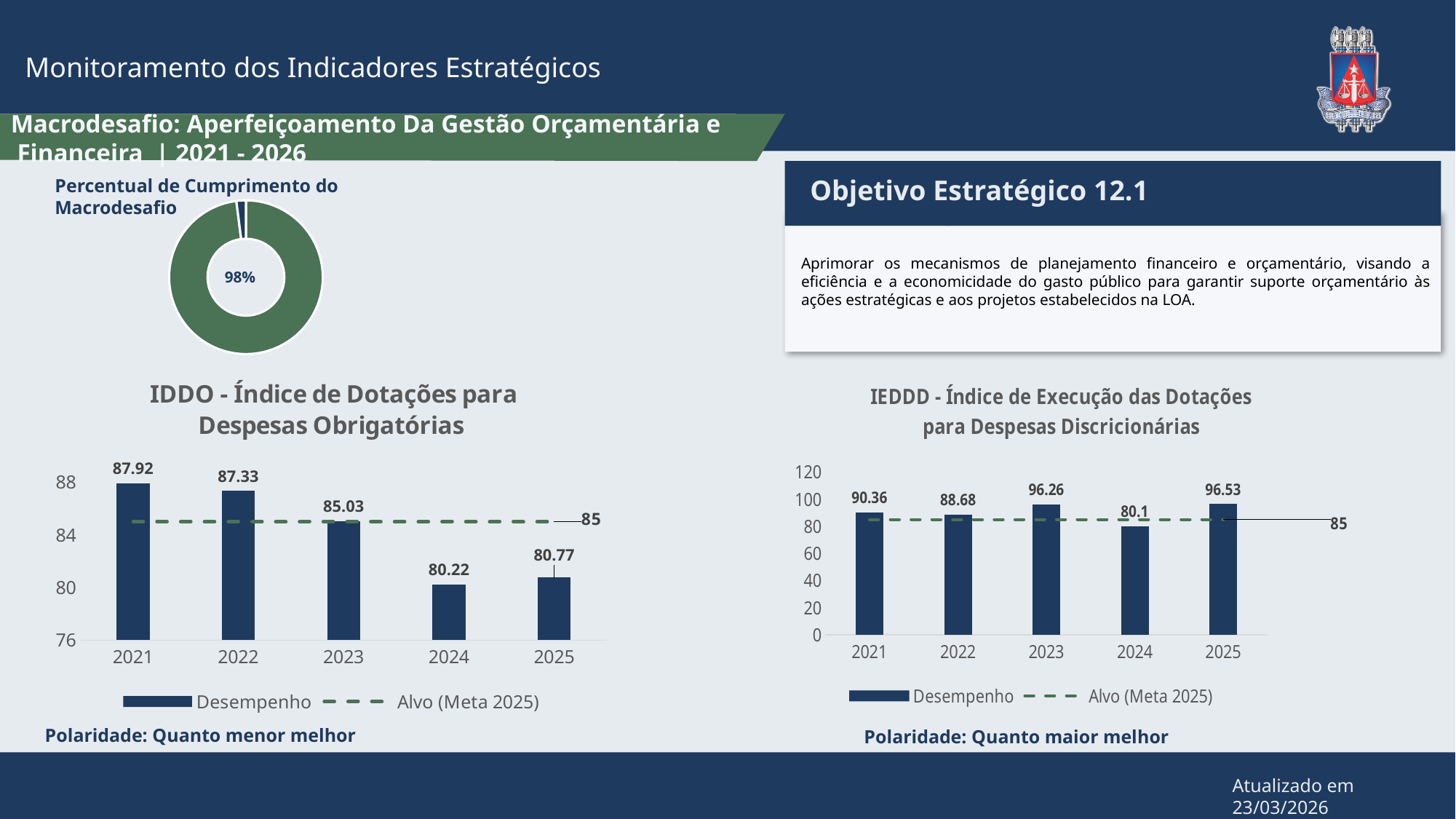
In the IEDDD chart, what is the Desempenho value for 2023? 96.26 In the IEDDD chart, which is larger, the Desempenho value for 2021 or for 2022? 2021 In the IEDDD chart, what is the difference between the 2025 and 2024 Desempenho values? 16.43 In the 'Percentual de Cumprimento do Macrodesafio' donut chart, what percentage is shown? 98% How many years are shown on the x axis of the IEDDD chart? 5 In the IEDDD chart, which year has the highest Desempenho value? 2025 How many series does the legend of the IDDO chart list? 2 In the IDDO chart, what is the value of the Alvo (Meta 2025) line? 85 In the IDDO chart, what is the difference between the 2021 and 2024 Desempenho values? 7.70 In the IDDO chart, what is the Desempenho value for 2021? 87.92 In the IDDO chart, what is the Desempenho value for 2024? 80.22 In the IDDO chart, which year has the lowest Desempenho value? 2024